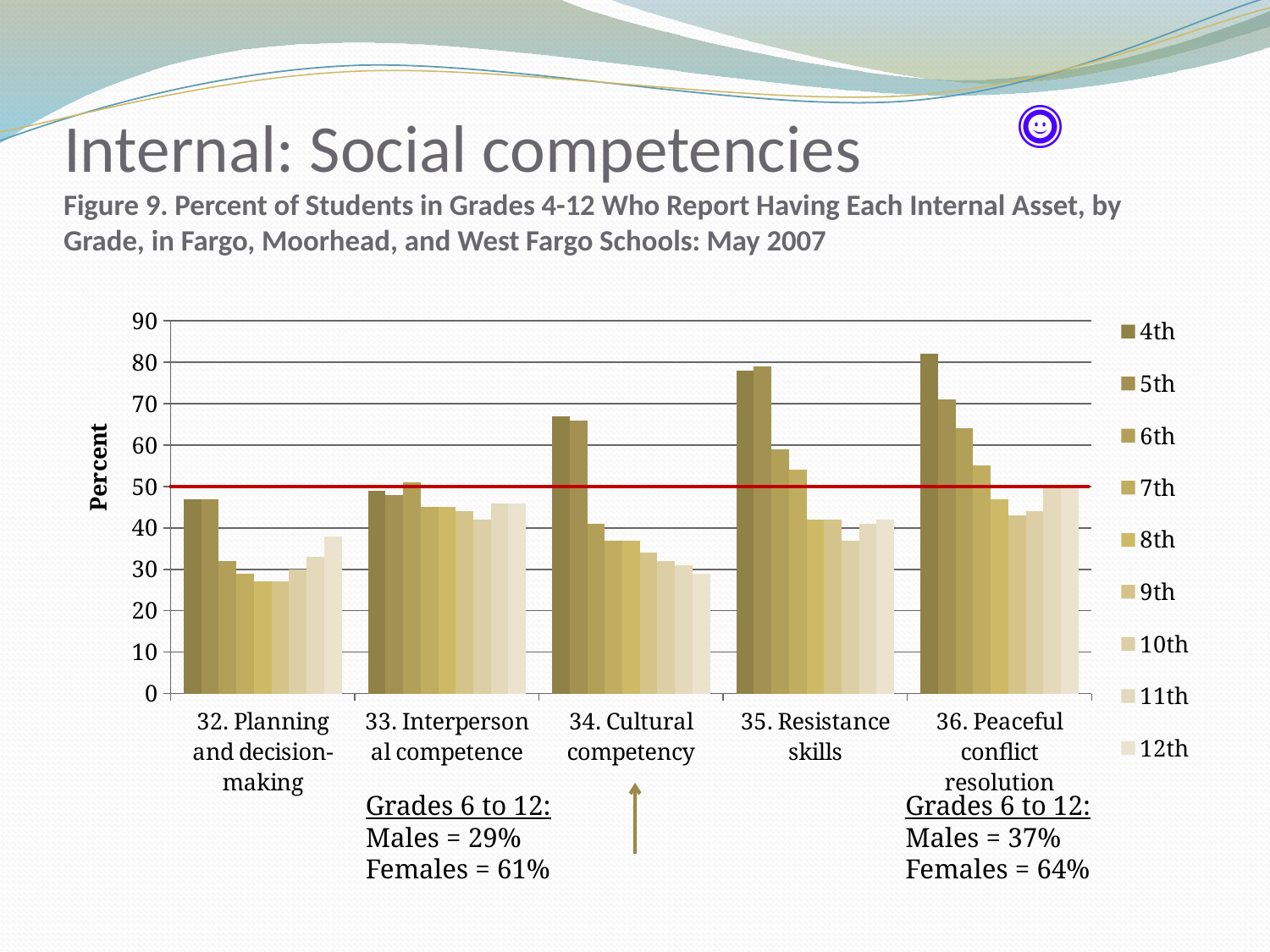
Within 34. Cultural competency, do the values rise or fall from 4th grade to 12th grade? fall Which asset category has the lowest 12th grade value? 34. Cultural competency Is the 4th grade value for 35. Resistance skills greater or less than 70? greater What is the label on the y axis? Percent What kind of chart is shown on the slide? bar chart How many grade series does the legend list? 9 How many asset categories are shown along the x axis? 5 Which is larger: the 4th grade value for 35. Resistance skills or the 4th grade value for 34. Cultural competency? 35. Resistance skills Is the 4th grade value for 36. Peaceful conflict resolution greater or less than 70? greater At what value on the y axis is the red horizontal line drawn? 50 Is the 4th grade value for 32. Planning and decision-making greater or less than 50? less